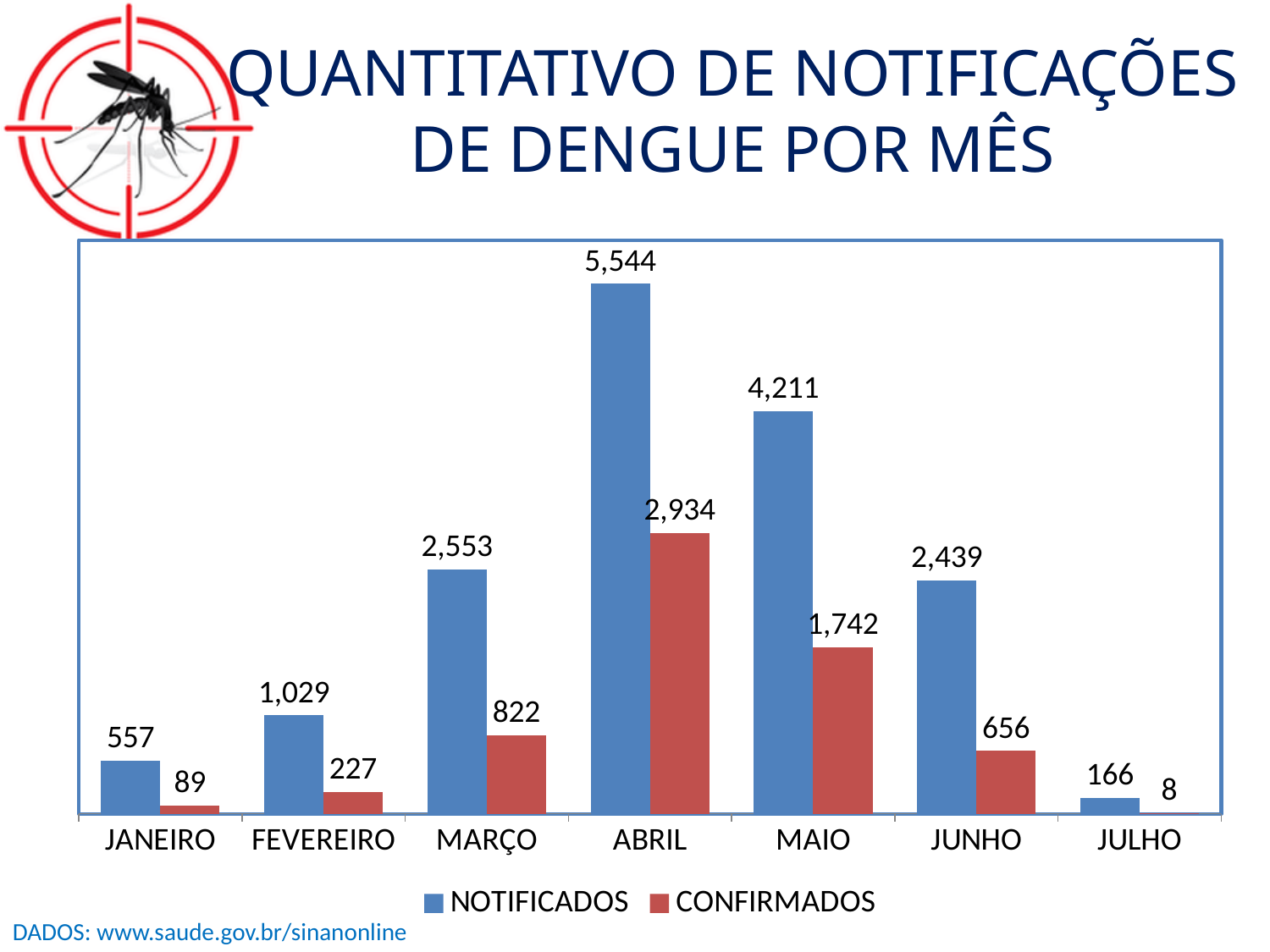
How many months are shown on the x axis? 7 How many series does the legend list? 2 What is the CONFIRMADOS value for JULHO? 8 Which month has the highest NOTIFICADOS value? ABRIL What is the difference between the NOTIFICADOS values for MAIO and JUNHO? 1,772 Which colour represents the CONFIRMADOS series? Red What is the NOTIFICADOS value for ABRIL? 5,544 Which is larger, the NOTIFICADOS value for MARÇO or for JUNHO? MARÇO What is the CONFIRMADOS value for MAIO? 1,742 What is the difference between NOTIFICADOS and CONFIRMADOS in ABRIL? 2,610 What kind of chart is shown on the slide? Bar chart Which month has the lowest CONFIRMADOS value? JULHO